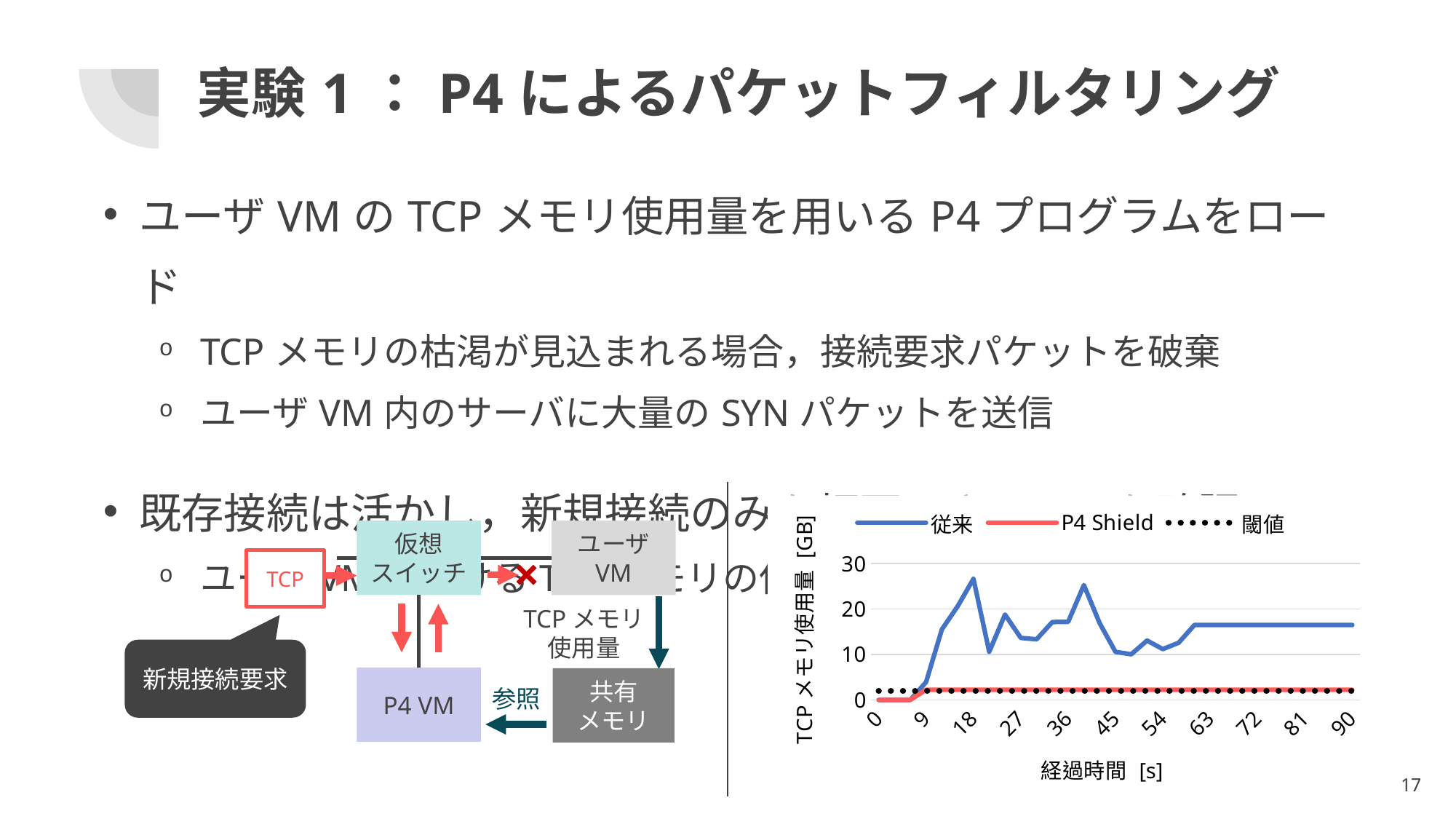
Is the value for 従来 at 90 s greater or less than 10? greater How many series does the chart legend list? 3 What is the label of the chart's y axis? TCP メモリ使用量 [GB] Is the peak value of the 従来 series greater or less than 30? less What are the three series named in the chart legend? 従来, P4 Shield, 閾値 At 36 s, which series has the larger value, 従来 or P4 Shield? 従来 Is the value for 従来 at 18 s greater or less than 20? greater How many tick labels are shown on the x axis (経過時間)? 11 What kind of chart is shown on the slide? line chart Does the 従来 series rise or fall between 0 s and 18 s? rise